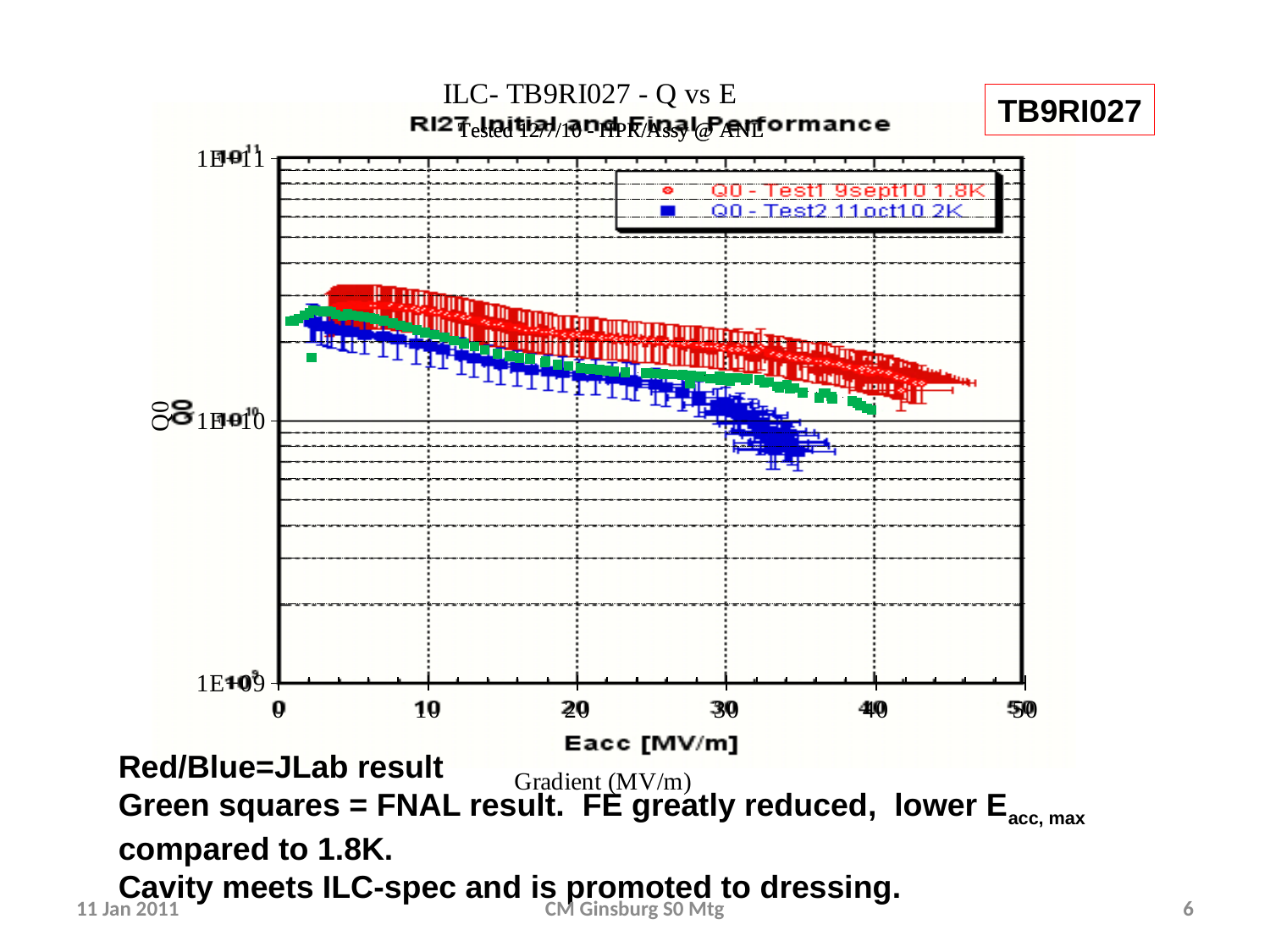
What kind of chart is shown on the slide? scatter chart Is the Q0 value of the red Test1 series at 10 MV/m greater or less than 1E+10? greater Which series reaches the highest Eacc value on the chart? Q0 - Test1 9sept10 1.8K At 20 MV/m, which series has the higher Q0: the red Test1 series or the blue Test2 series? red Test1 series What is the title of the chart on the slide? ILC- TB9RI027 - Q vs E Is the Q0 value of the blue Test2 series at 35 MV/m greater or less than 1E+10? less Is the maximum Eacc reached by the blue Test2 series greater or less than 40 MV/m? less How many series does the legend of the chart list? 2 Which series has the lowest Q0 values on the chart? Q0 - Test2 11oct10 2K Do the Q0 values rise or fall as Eacc increases along the x axis? fall